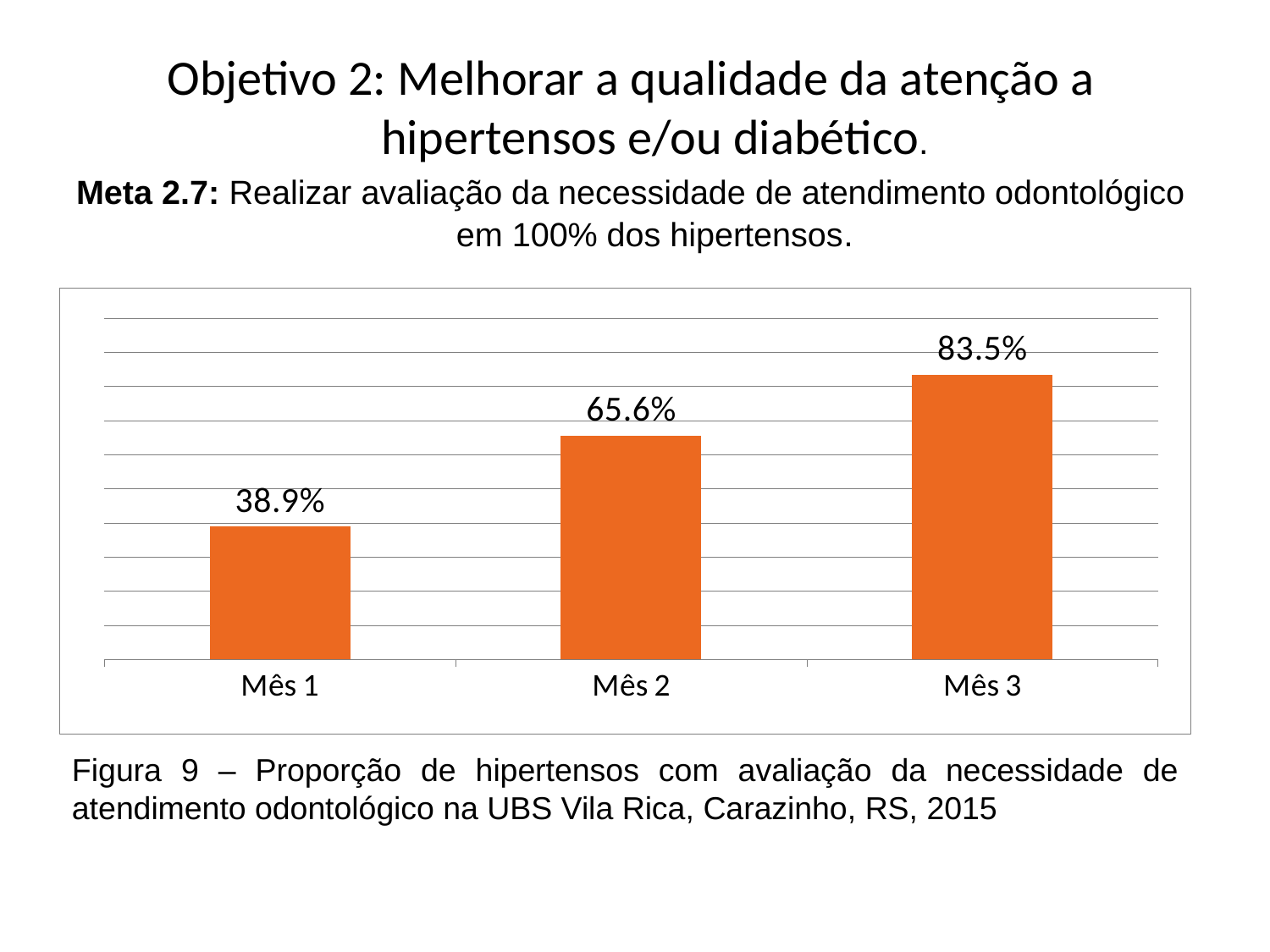
What is the value for Mês 1? 38.9% What is the difference between the values for Mês 3 and Mês 1? 44.6% What kind of chart is shown on the slide? Bar chart What is the difference between the values for Mês 2 and Mês 1? 26.7% Which month has the highest value? Mês 3 What is the value for Mês 2? 65.6% Which is larger, the value for Mês 2 or the value for Mês 3? Mês 3 Do the values rise or fall from Mês 1 to Mês 3? Rise What colour are the bars in the chart? Orange How many months are shown on the chart? 3 What is the value for Mês 3? 83.5% Which month has the lowest value? Mês 1